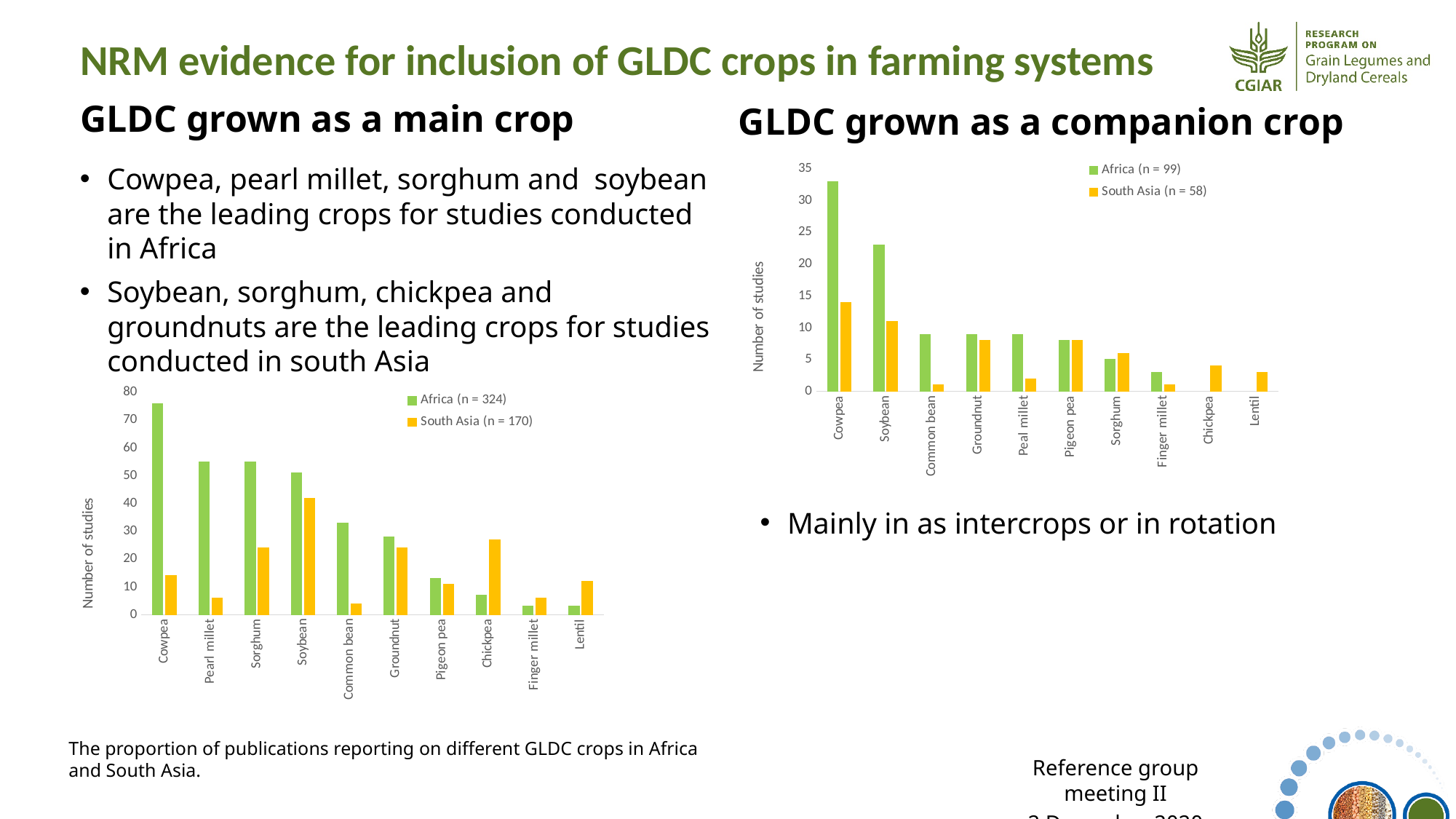
What kind of chart is the 'GLDC grown as a main crop' chart? Bar chart In the 'GLDC grown as a main crop' chart, which crop has the highest number of studies for Africa? Cowpea In the 'GLDC grown as a main crop' chart, which crop has the highest number of studies for South Asia? Soybean In the 'GLDC grown as a companion crop' chart, is the Africa value for Soybean greater or less than 20? greater In the 'GLDC grown as a main crop' chart, which is larger for Chickpea: the Africa value or the South Asia value? South Asia In the 'GLDC grown as a companion crop' chart, is the Africa value for Cowpea greater or less than 30? greater In the 'GLDC grown as a companion crop' chart, which crop has the highest number of studies for Africa? Cowpea How many series does the legend of the 'GLDC grown as a companion crop' chart list? 2 How many crop categories are shown on the x axis of the 'GLDC grown as a main crop' chart? 10 In the 'GLDC grown as a companion crop' chart, which is larger for Soybean: the Africa value or the South Asia value? Africa In the 'GLDC grown as a main crop' chart, is the Africa value for Cowpea greater or less than 70? greater